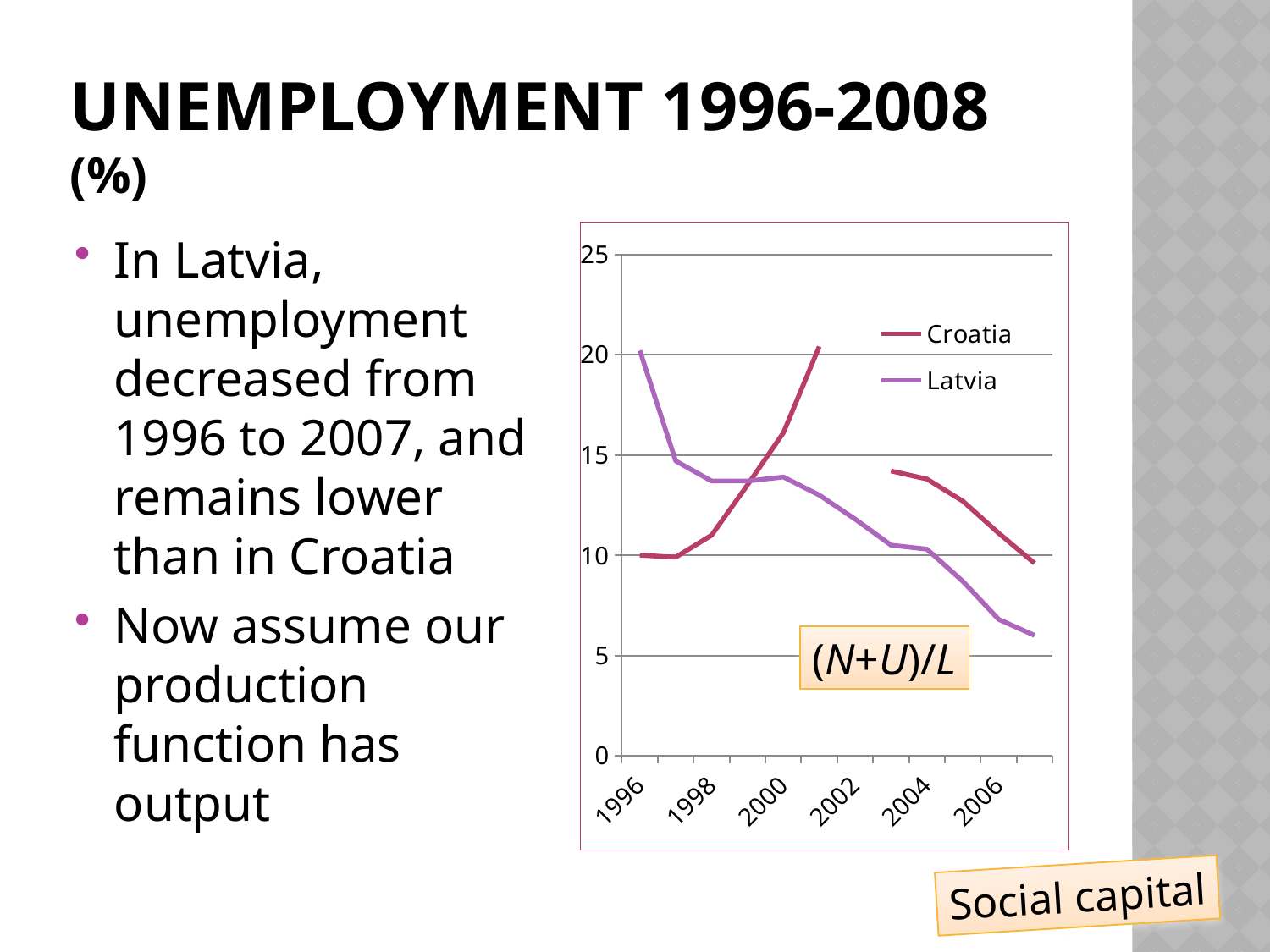
In 1996, which country has the higher unemployment rate, Croatia or Latvia? Latvia Is the value for Croatia in 1996 greater or less than 15? less In 2006, which country has the higher unemployment rate, Croatia or Latvia? Croatia What kind of chart is shown on the slide? line chart Does the Latvia line rise or fall from 1996 to 2006? fall What colour is the Latvia line in the chart? purple Is the value for Latvia in 2006 greater or less than 10? less How many year labels are shown on the x axis of the chart? 6 Is the value for Latvia in 1996 greater or less than 15? greater How many series does the chart's legend list? 2 Which two countries are plotted in the chart? Croatia and Latvia